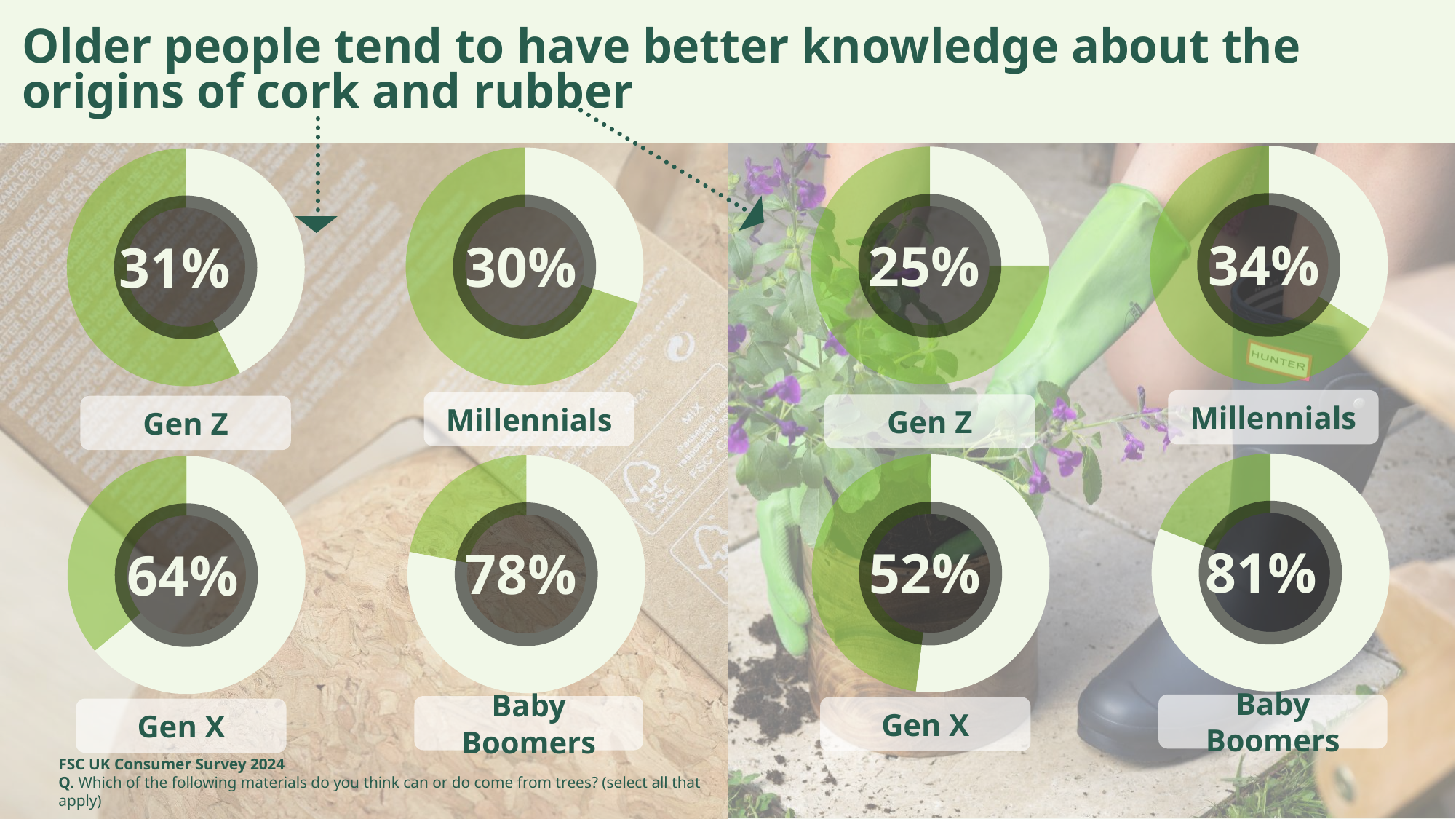
Which is larger: the Gen X percentage in the left-hand (cork) group or the Gen X percentage in the right-hand (rubber) group? Left-hand (cork) group, 64% In the right-hand (rubber) group of charts, which generation has the lowest percentage? Gen Z In the right-hand (rubber) group of charts, what is the difference between the Baby Boomers and Gen Z percentages? 56% What survey is cited as the source of the data on the slide? FSC UK Consumer Survey 2024 In the right-hand (rubber) group of charts, what percentage is shown for Gen X? 52% In the left-hand (cork) group of charts, what percentage is shown for Baby Boomers? 78% How many donut charts are shown on the slide in total? 8 In the left-hand (cork) group of charts, which generation has the highest percentage? Baby Boomers In the left-hand (cork) group of charts, what is the difference between the Gen X and Millennials percentages? 34% In the left-hand (cork) group of charts, what percentage is shown for Gen Z? 31% In the right-hand (rubber) group of charts, what percentage is shown for Millennials? 34% What type of chart is used to show each generation's percentage on the slide? Donut (pie) chart